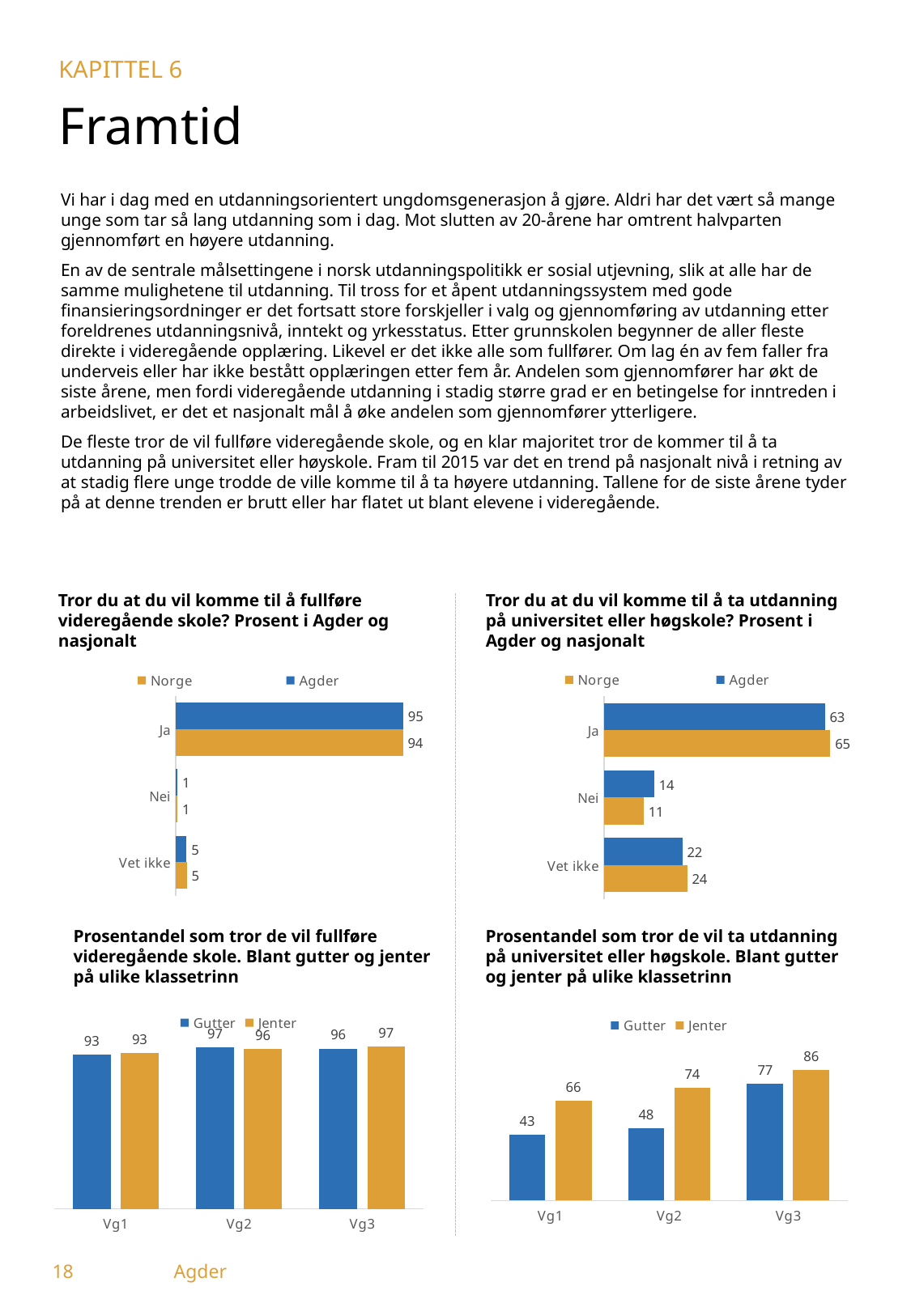
In the bottom-left chart (Prosentandel som tror de vil fullføre videregående skole), how many series does the legend list? 2 In the top-right chart (Tror du at du vil komme til å ta utdanning på universitet eller høgskole?), what is the value for Norge for 'Ja'? 65 In the bottom-right chart (Prosentandel som tror de vil ta utdanning på universitet eller høgskole), what is the value for Gutter at Vg1? 43 In the top-right chart (Tror du at du vil komme til å ta utdanning på universitet eller høgskole?), how many categories are shown? 3 In the top-left chart (Tror du at du vil komme til å fullføre videregående skole?), what is the value for Norge for 'Vet ikke'? 5 In the bottom-right chart (Prosentandel som tror de vil ta utdanning på universitet eller høgskole), which class level has the highest value for Jenter? Vg3 In the top-right chart (Tror du at du vil komme til å ta utdanning på universitet eller høgskole?), what is the difference between Agder and Norge for 'Nei'? 3 In the top-left chart (Tror du at du vil komme til å fullføre videregående skole?), what is the value for Agder for 'Ja'? 95 In the bottom-right chart (Prosentandel som tror de vil ta utdanning på universitet eller høgskole), what is the difference between Jenter and Gutter at Vg2? 26 In the bottom-left chart (Prosentandel som tror de vil fullføre videregående skole), what is the value for Jenter at Vg2? 96 In the bottom-right chart (Prosentandel som tror de vil ta utdanning på universitet eller høgskole), do the values for Gutter rise or fall from Vg1 to Vg3? rise In the top-right chart (Tror du at du vil komme til å ta utdanning på universitet eller høgskole?), which is larger for 'Vet ikke', Norge or Agder? Norge